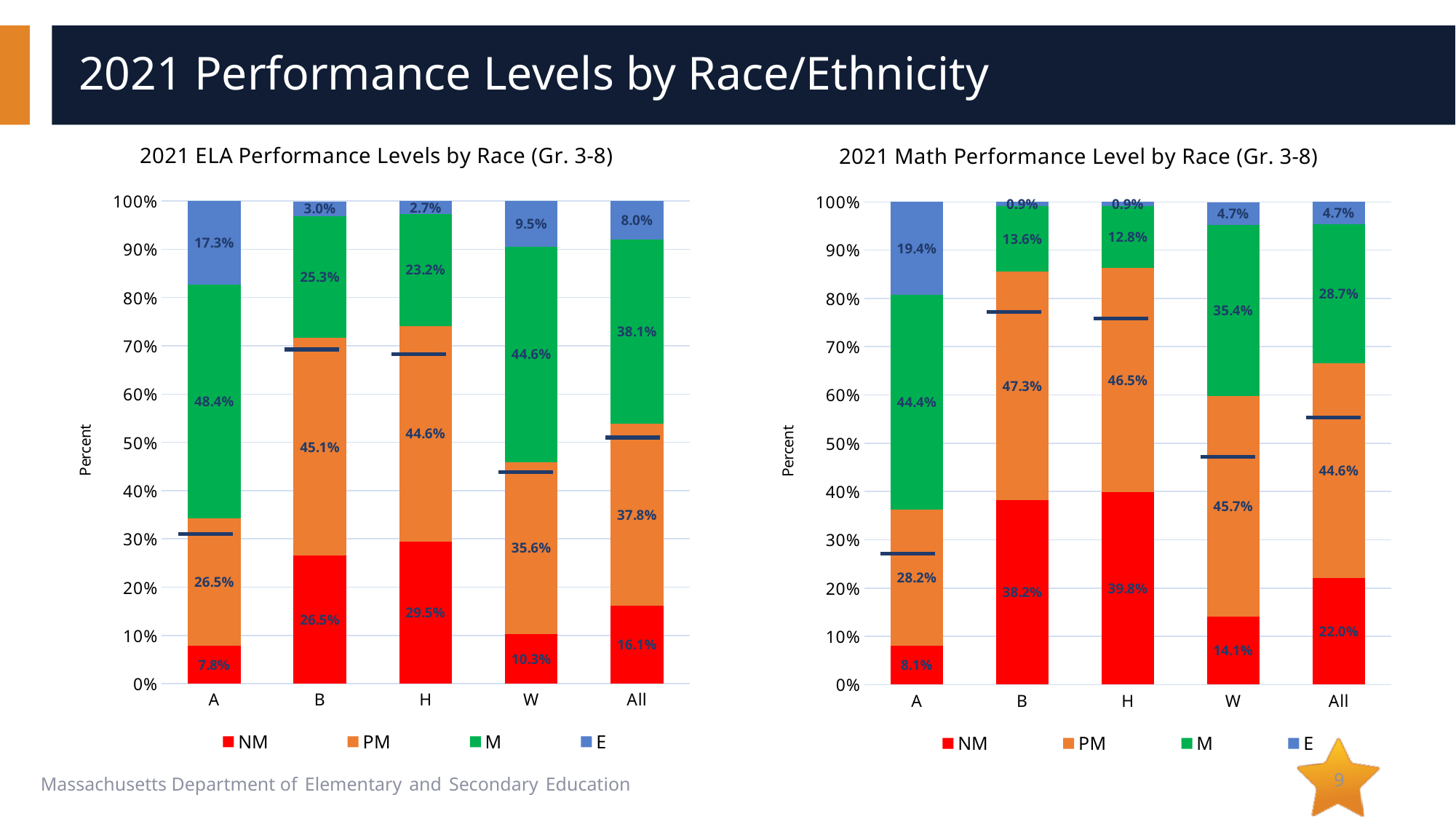
In the 2021 Math Performance Level by Race chart, what colour represents the E series? Blue How many series does the legend of the 2021 Math Performance Level by Race chart list? 4 What kind of chart is the 2021 ELA Performance Levels by Race chart? Stacked bar chart In the 2021 Math Performance Level by Race chart, which category has the highest NM value? H In the 2021 Math Performance Level by Race chart, what is the M value for category W? 35.4% In the 2021 ELA Performance Levels by Race chart, what is the NM value for category H? 29.5% In the 2021 ELA Performance Levels by Race chart, what is the E value for category A? 17.3% In the 2021 Math Performance Level by Race chart, is the PM value for All greater or less than 40%? greater How many categories are shown on the x axis of the 2021 ELA Performance Levels by Race chart? 5 In the 2021 ELA Performance Levels by Race chart, which is larger: the M value for A or the M value for W? A In the 2021 ELA Performance Levels by Race chart, which category has the lowest E value? H In the 2021 Math Performance Level by Race chart, what is the difference between the NM values for B and A? 30.1%